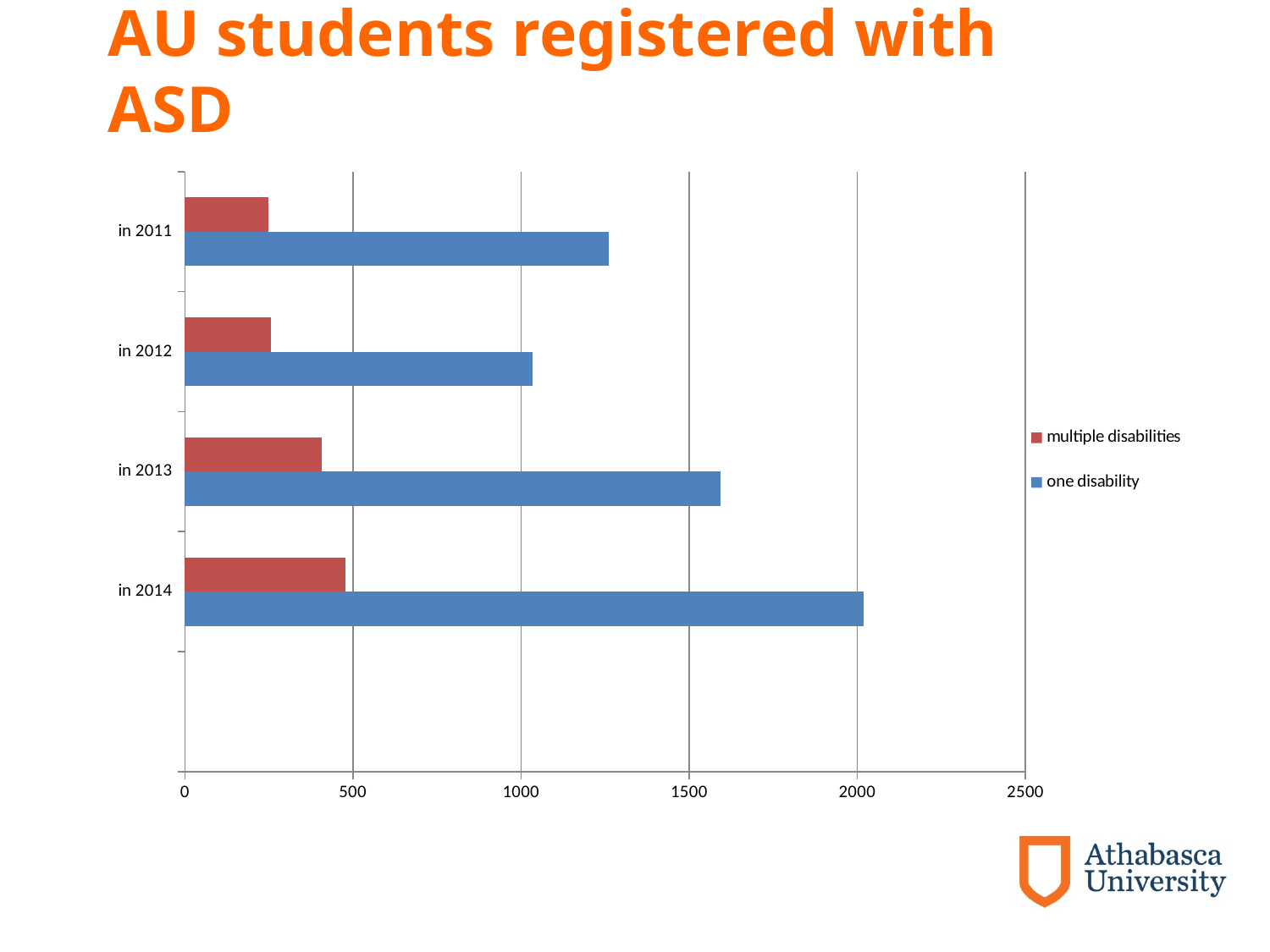
In which year is the 'multiple disabilities' bar the longest? in 2014 Does the 'one disability' value rise or fall from 2012 to 2014? rise Is the 'one disability' value for 2014 greater or less than 1500? greater Is the 'one disability' value for 2012 greater or less than 1500? less In which year is the 'one disability' bar the longest? in 2014 In which year is the 'one disability' bar the shortest? in 2012 Which is larger: the 'one disability' value in 2013 or in 2011? 2013 Which colour represents 'multiple disabilities' in the legend? red How many series does the legend list? 2 Is the 'multiple disabilities' value for 2013 greater or less than 500? less How many years (categories) are shown on the chart? 4 What kind of chart is shown on the slide? bar chart